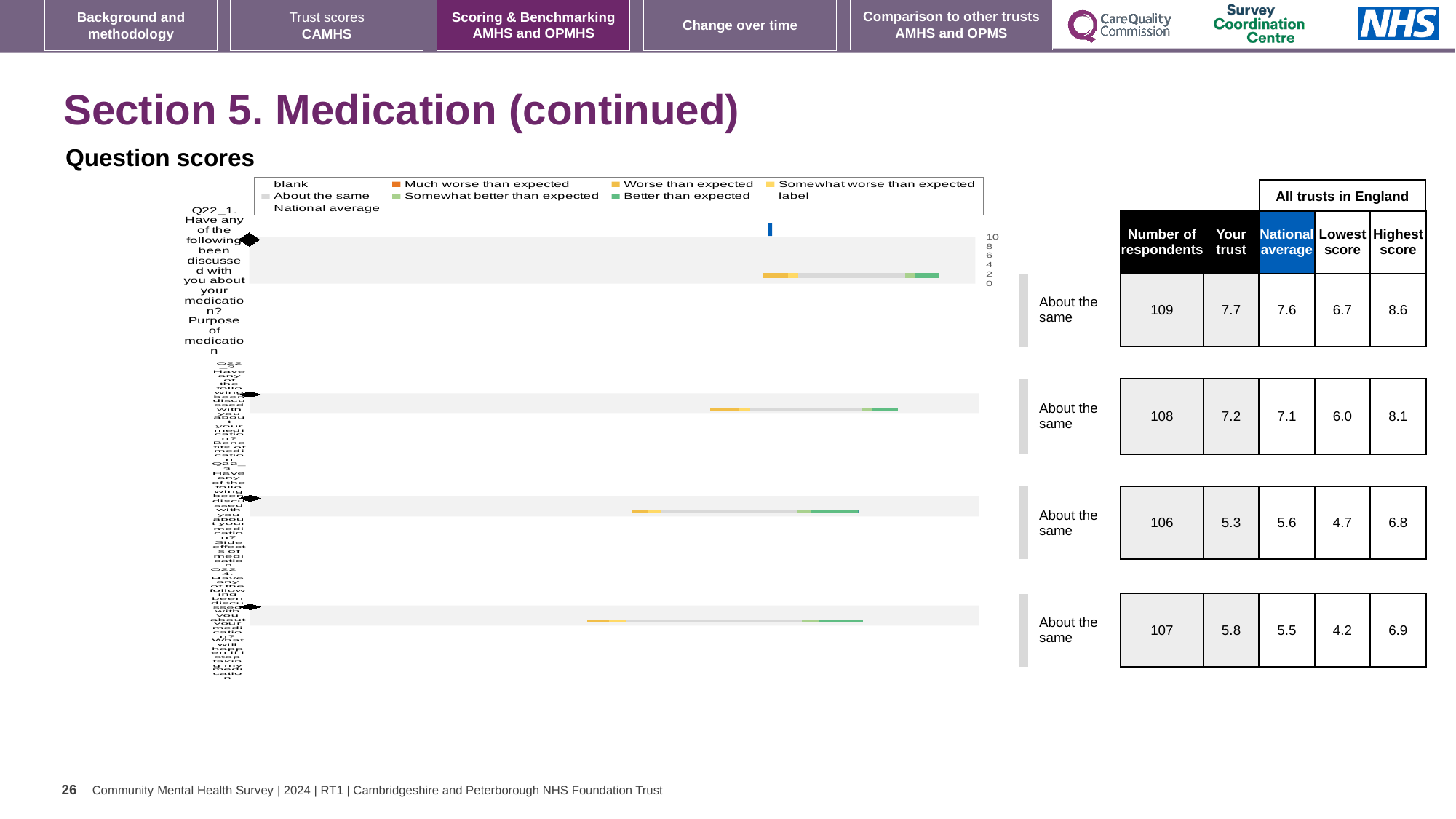
What benchmark category label is shown next to the first bar (Q22_1, Purpose of medication)? About the same What is the maximum value shown on the chart's score axis? 10 In the table beside the chart, which row has the lowest 'Your trust' score? the third row, 5.3 How many question rows (bars) are plotted in the question scores chart? 4 In the table beside the chart, what is the 'Your trust' score for the first row (Q22_1, Purpose of medication)? 7.7 In the table beside the chart, what is the difference between the highest score and the lowest score for the first row (Q22_1)? 1.9 In the table beside the chart, which row has the highest 'Your trust' score? the first row (Q22_1, Purpose of medication), 7.7 Which legend entry is shown in the darkest green colour? Better than expected In the table beside the chart, for the fourth row, which is larger: the 'Your trust' score or the national average? Your trust (5.8) What kind of chart is used to show the question scores on this slide? bar chart In the table beside the chart, what is the national average for the first row (Q22_1, Purpose of medication)? 7.6 In the table beside the chart, what is the number of respondents for the first row (Q22_1, Purpose of medication)? 109